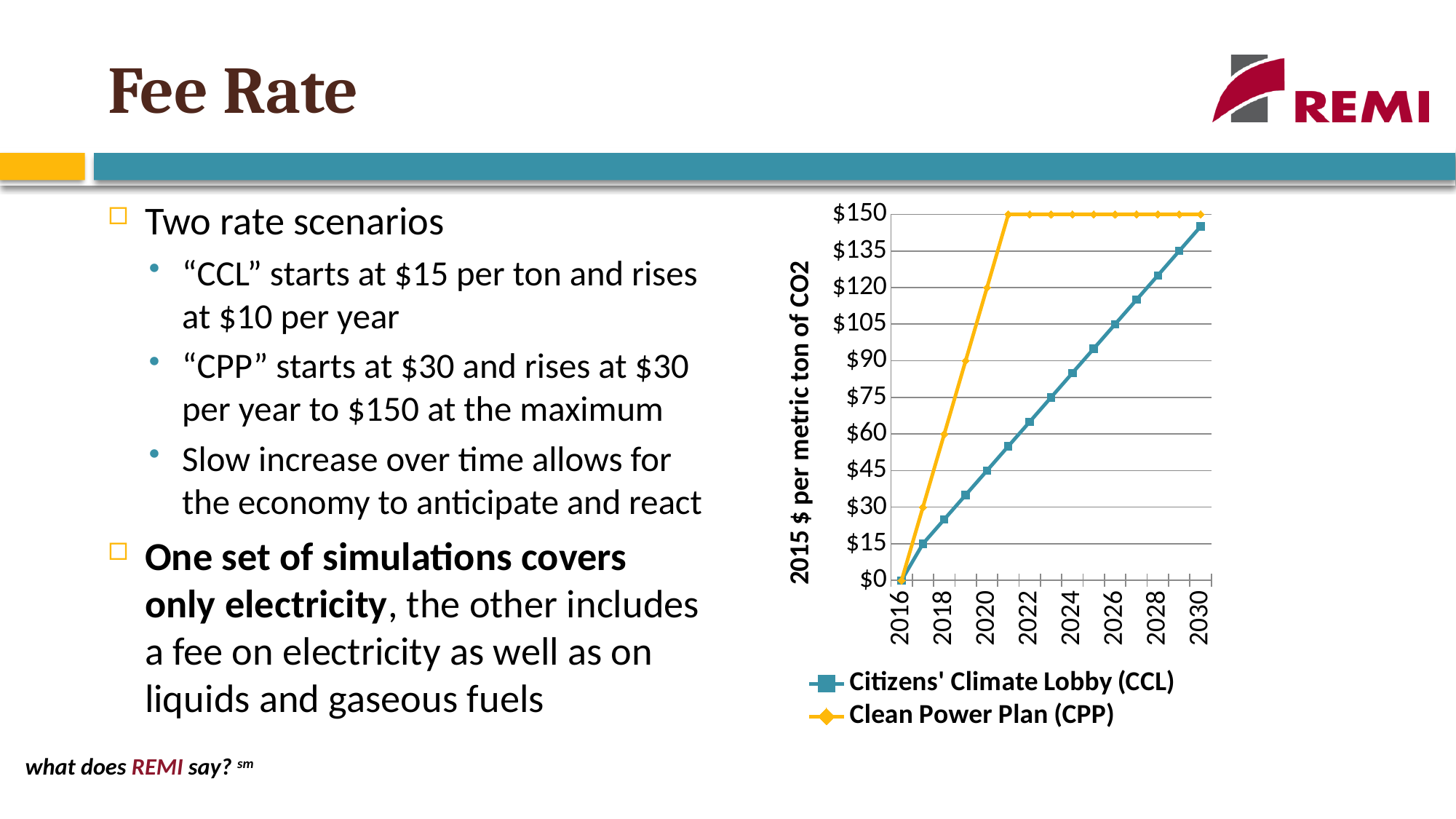
Does the Citizens' Climate Lobby (CCL) line rise or fall from 2016 to 2030? rise What is the Clean Power Plan (CPP) fee rate in 2020? $120 Is the Citizens' Climate Lobby (CCL) value for 2020 greater or less than $60? less How many series does the chart legend list? 2 Is the Citizens' Climate Lobby (CCL) value for 2030 greater or less than $135? greater In 2020, which series has the higher fee rate, CCL or CPP? Clean Power Plan (CPP) What kind of chart is shown on the slide? line chart What is the label on the chart's vertical axis? 2015 $ per metric ton of CO2 What is the Clean Power Plan (CPP) fee rate in 2030? $150 What is the difference between the CPP fee rate in 2021 and the CPP fee rate in 2017? $120 What is the Citizens' Climate Lobby (CCL) fee rate in 2023? $75 What is the Citizens' Climate Lobby (CCL) fee rate in 2017? $15